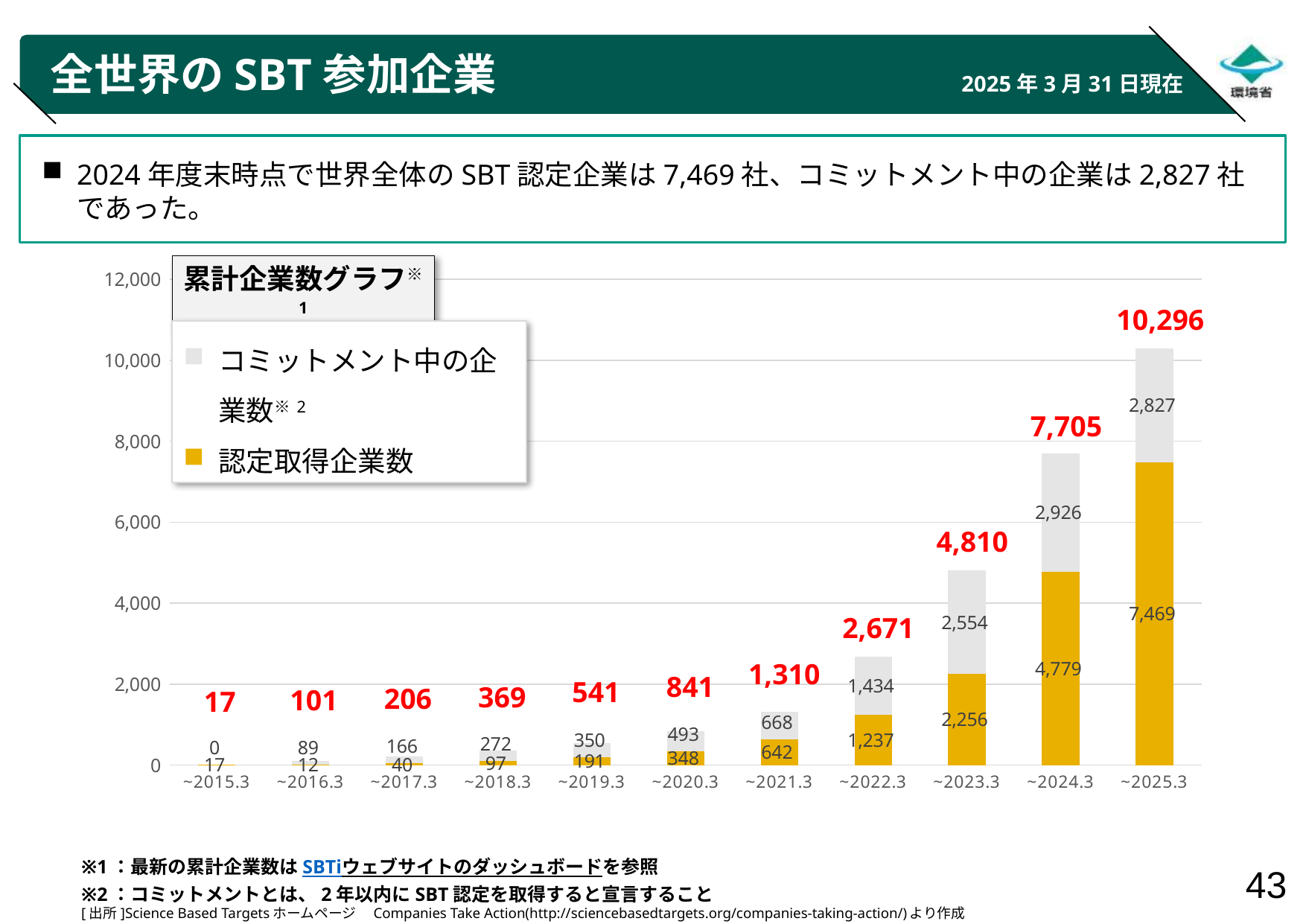
How many categories (time periods) are shown on the x axis? 11 What is the difference between 認定取得企業数 for ~2025.3 and ~2024.3? 2,690 What kind of chart is shown on the slide? stacked bar chart Which colour represents 認定取得企業数 in the chart? gold (yellow) Do the total values rise or fall from ~2015.3 to ~2025.3? rise How many series does the legend list? 2 What is the value of コミットメント中の企業数 for ~2024.3? 2,926 Which period has the highest total number of companies? ~2025.3 For ~2022.3, which is larger: コミットメント中の企業数 or 認定取得企業数? コミットメント中の企業数 Which period has the lowest total number of companies? ~2015.3 What is the total of the stacked bar for ~2023.3? 4,810 What is the value of 認定取得企業数 for ~2025.3? 7,469